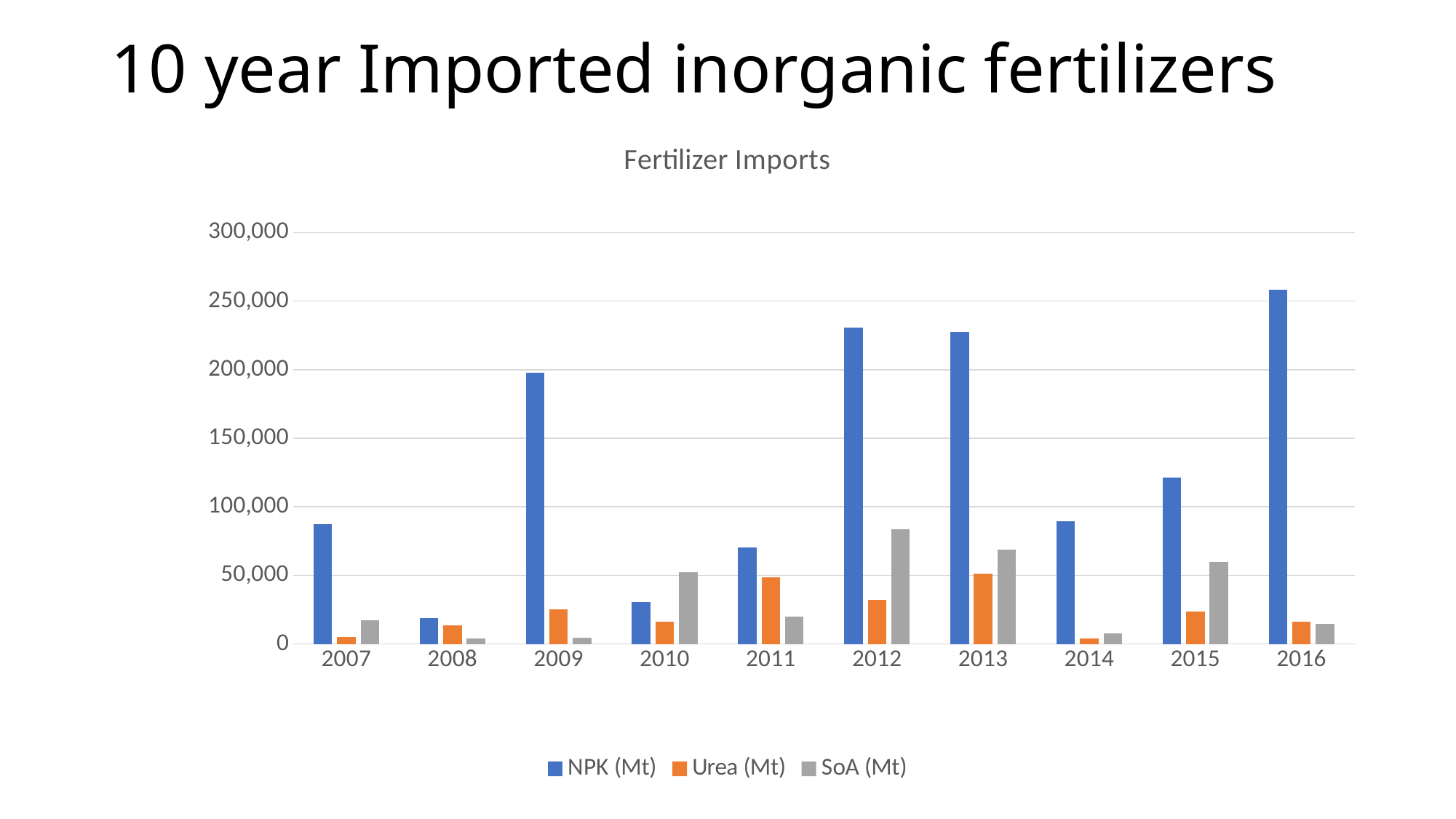
In which year is the NPK (Mt) value highest? 2016 How many years are shown on the x axis? 10 In which year is the SoA (Mt) value highest? 2012 Which is larger, the NPK (Mt) value for 2009 or for 2015? 2009 Is the SoA (Mt) value for 2012 greater or less than 50,000? greater How many series does the legend list? 3 In 2010, which is larger, Urea (Mt) or SoA (Mt)? SoA (Mt) In which year is the NPK (Mt) value lowest? 2008 What kind of chart is shown on the slide? Bar chart Is the NPK (Mt) value for 2015 greater or less than 100,000? greater What is the title of the chart? Fertilizer Imports Is the NPK (Mt) value for 2016 greater or less than 250,000? greater